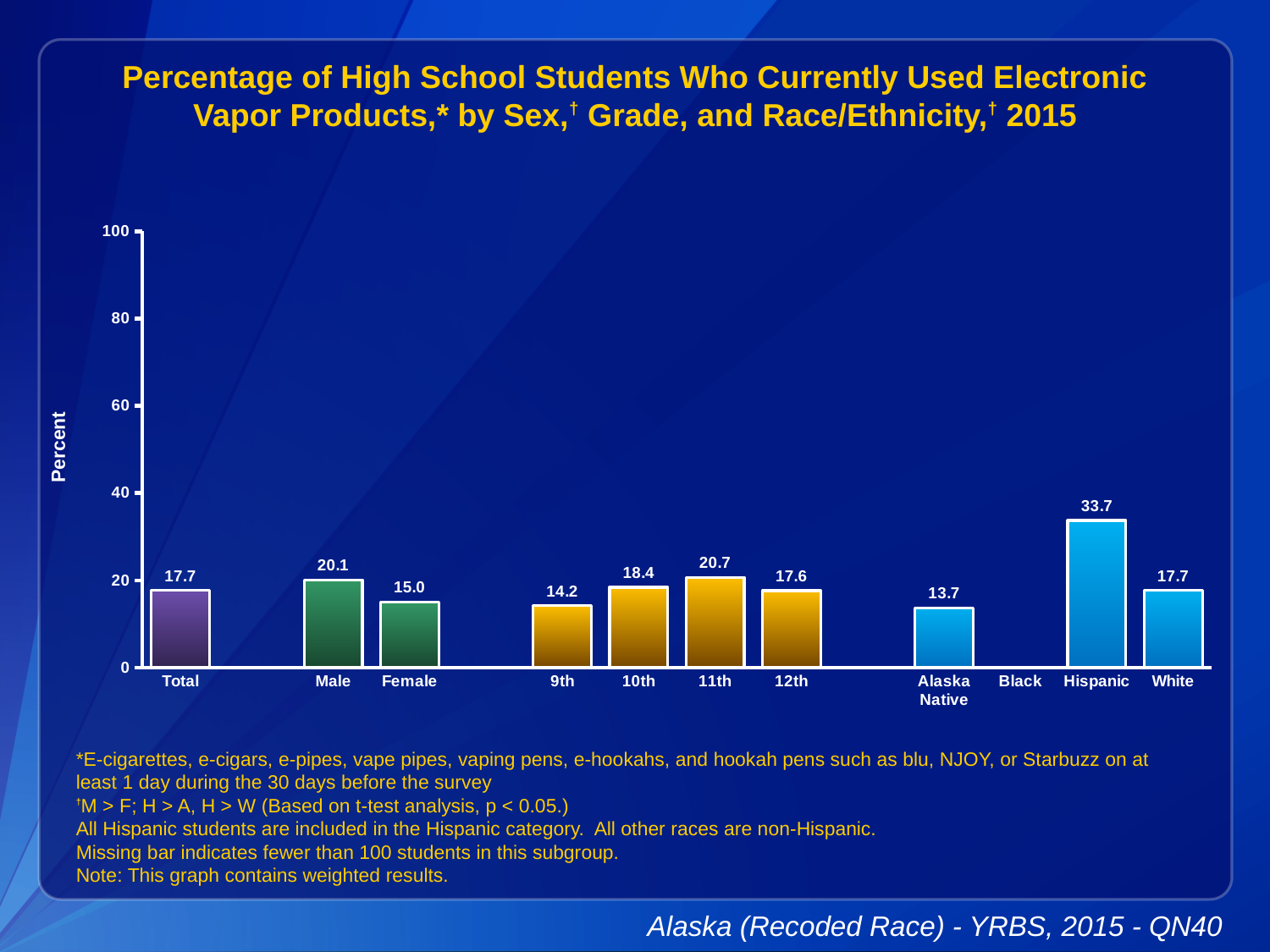
Which category has the highest value? Hispanic What is the difference between the Male and Female values? 5.1 Which category on the x axis has no bar? Black What is the value for Total? 17.7 Which is larger, the value for 11th grade or 12th grade? 11th Is the value for Hispanic greater or less than 40? less What kind of chart is this? bar chart What is the value for 9th grade? 14.2 Which category with a bar has the lowest value? Alaska Native What is the value for Male? 20.1 How many categories have a bar plotted? 10 What is the value for Hispanic? 33.7